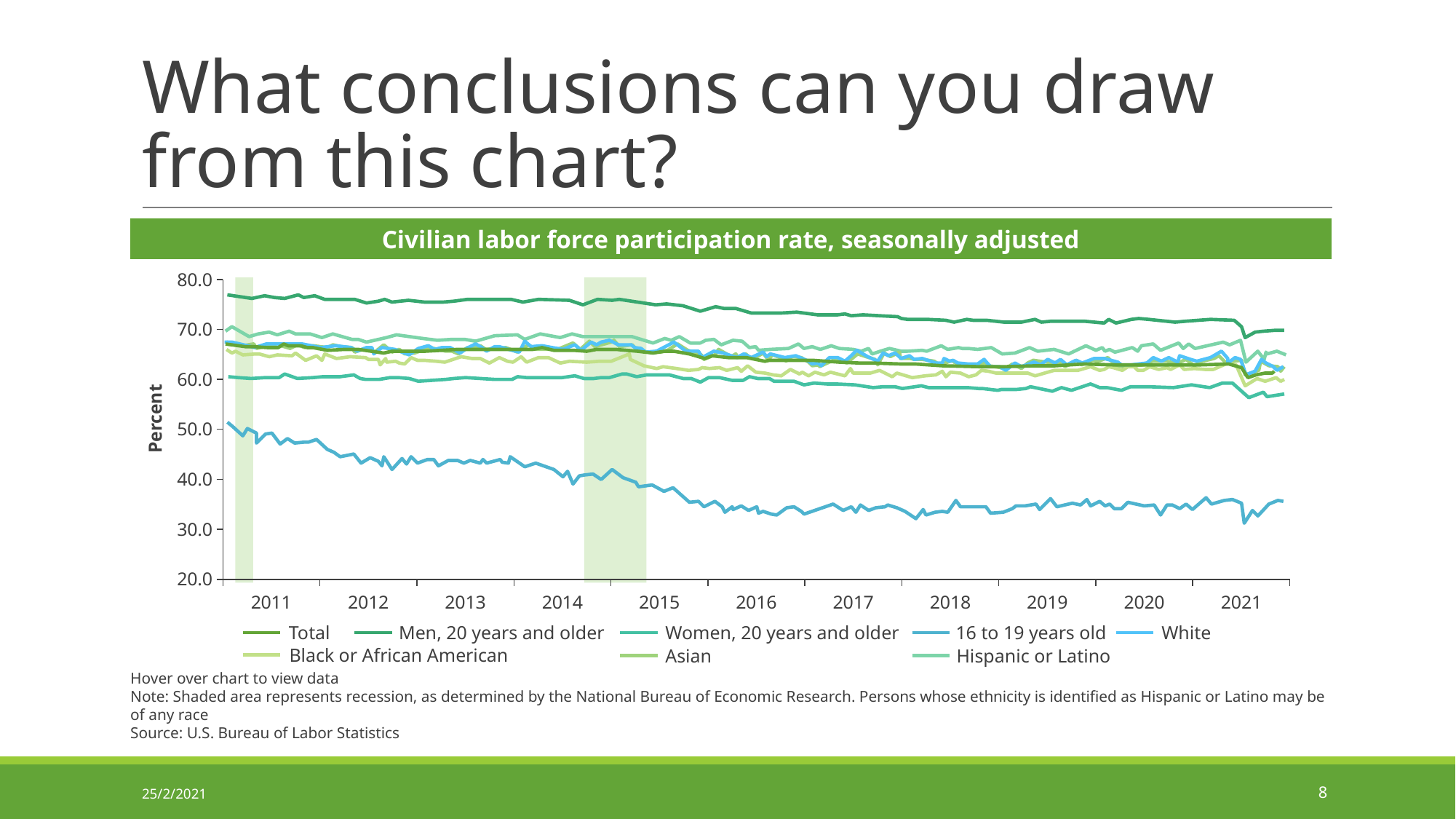
Which series has the lowest values throughout the chart? 16 to 19 years old How many year labels are shown on the x axis? 11 Does the value for 16 to 19 years old rise or fall from 2011 to 2016? fall What is the label on the vertical axis of the chart? Percent Which is larger in 2018: the value for Men, 20 years and older or the value for Women, 20 years and older? Men, 20 years and older What kind of chart is shown on the slide? Line chart Is the value for 16 to 19 years old in 2012 greater or less than 50.0? less How many series does the legend list? 8 What is the title of the chart? Civilian labor force participation rate, seasonally adjusted Is the value for 16 to 19 years old in 2017 greater or less than 40.0? less Is the value for Men, 20 years and older in 2011 greater or less than 70.0? greater Which series has the highest values throughout the chart? Men, 20 years and older